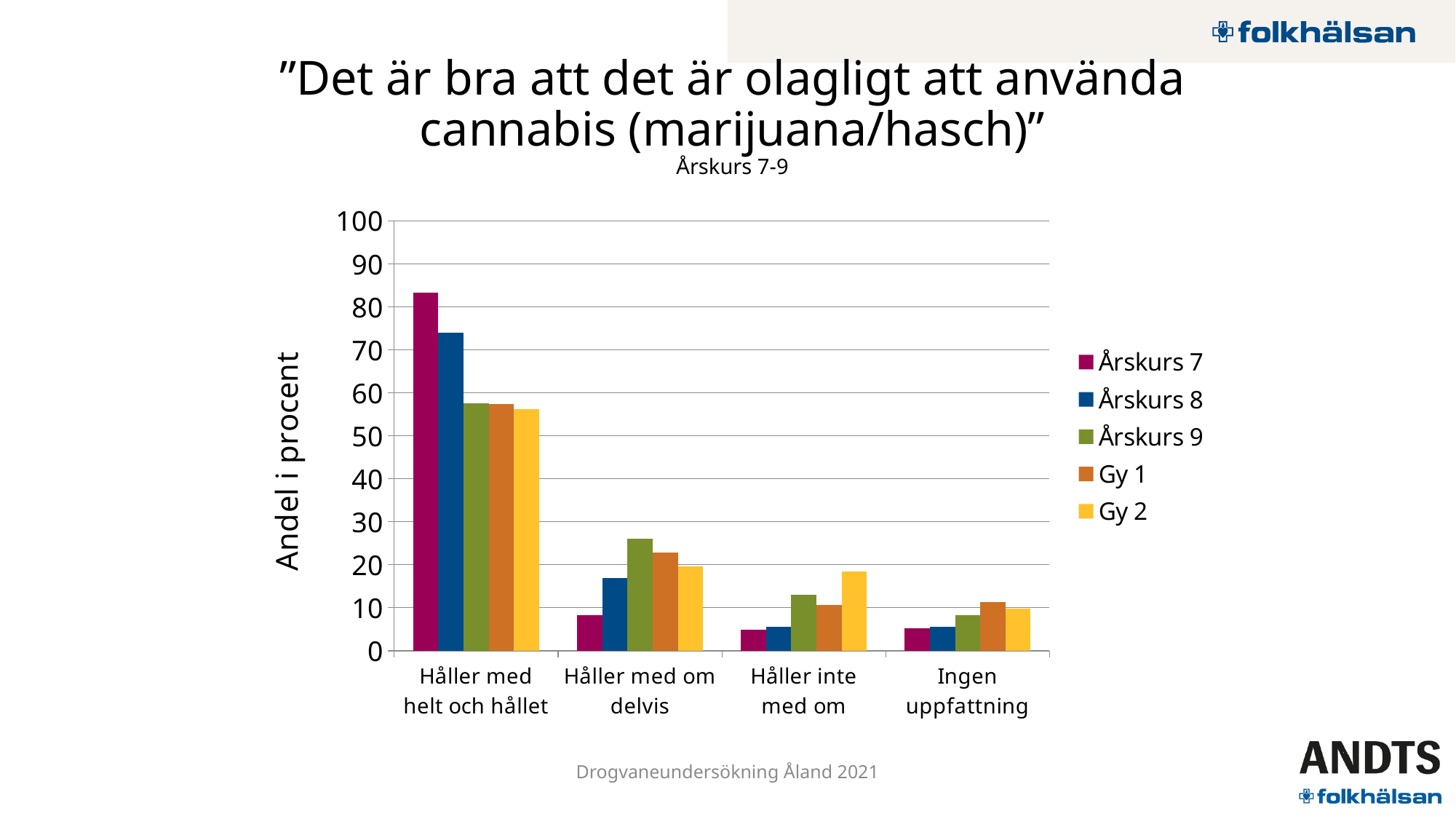
Is the value for Gy 2 in "Håller inte med om" greater or less than 20? less What is the label on the vertical axis of the chart? Andel i procent How many series does the legend list? 5 Which series has the highest value for "Håller med helt och hållet"? Årskurs 7 Is the value for Årskurs 8 in "Håller med helt och hållet" greater or less than 70? greater Which series has the lowest value for "Håller med om delvis"? Årskurs 7 How many response categories are shown on the x axis? 4 What kind of chart is shown on the slide? bar chart Is the value for Årskurs 9 in "Håller med om delvis" greater or less than 20? greater For "Håller med om delvis", which is larger: Årskurs 9 or Årskurs 7? Årskurs 9 Which series has the highest value for "Håller inte med om"? Gy 2